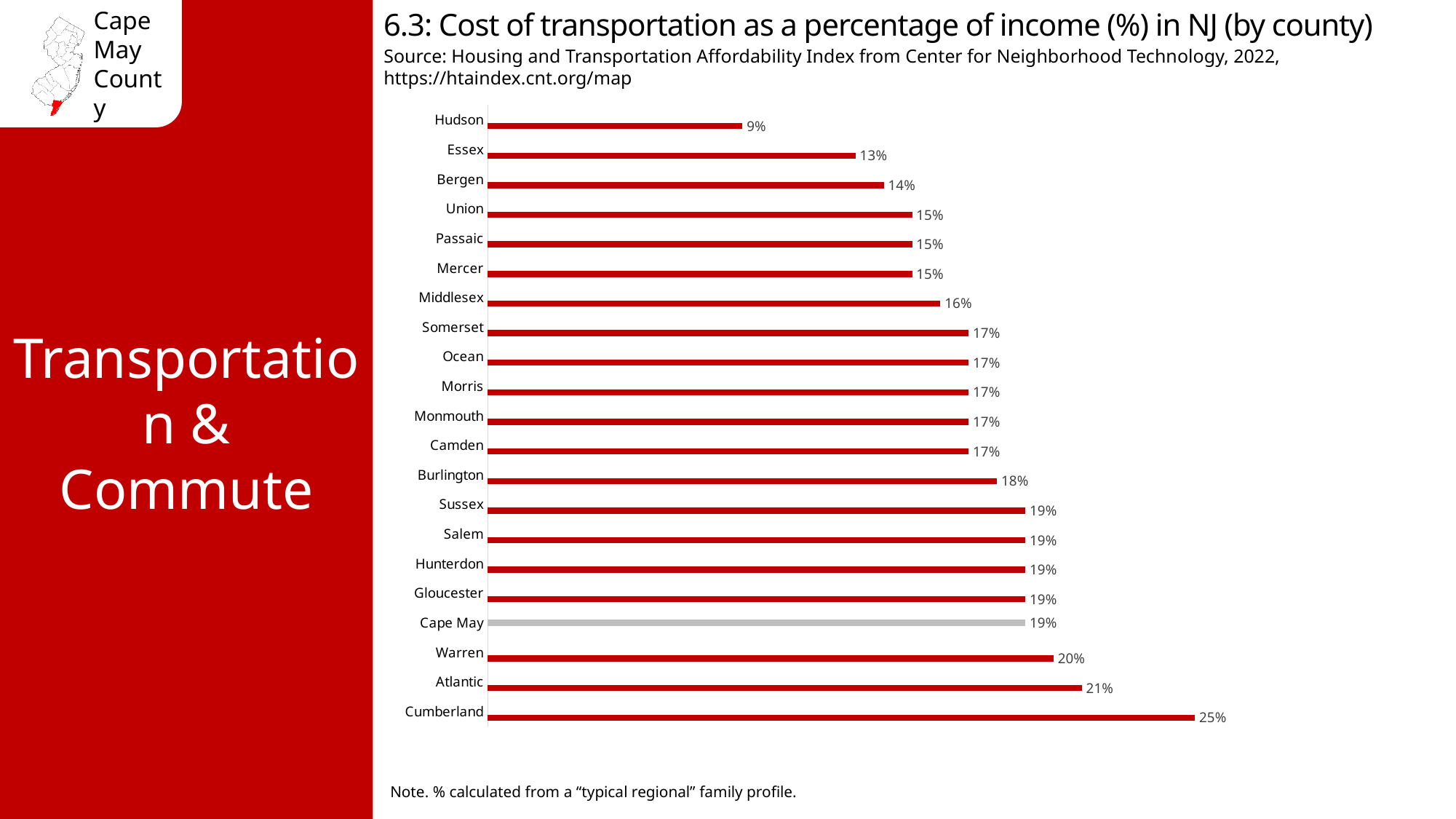
How many counties are shown in the chart? 21 What is the cost of transportation as a percentage of income for Cape May county? 19% What is the difference between the values for Warren and Essex? 7% What is the value shown for Middlesex county? 16% Which county's bar is shown in grey rather than red? Cape May What is the difference between the values for Cumberland and Hudson? 16% Which county has the lowest cost of transportation as a percentage of income? Hudson What kind of chart is shown on the slide? Bar chart What is the value shown for Hudson county? 9% What is the value shown for Atlantic county? 21% Which county has the highest cost of transportation as a percentage of income? Cumberland Which county has a larger value, Bergen or Burlington? Burlington